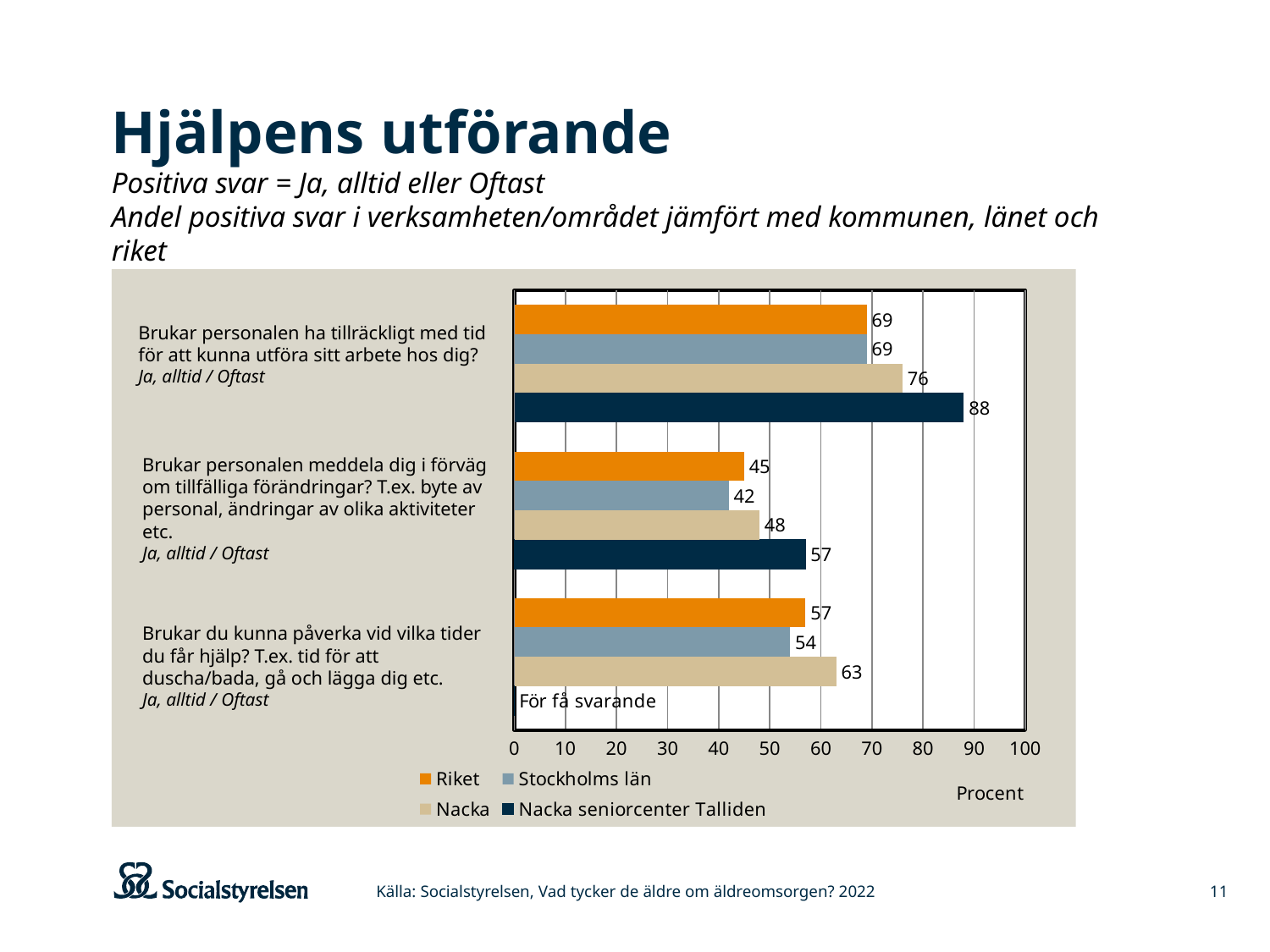
What value is shown for Nacka seniorcenter Talliden on the question about whether staff usually have enough time to do their work ("Brukar personalen ha tillräckligt med tid...")? 88 Which series has the lowest value on the question about staff informing in advance about temporary changes ("Brukar personalen meddela dig i förväg...")? Stockholms län What is the label of the x axis? Procent What value is shown for Stockholms län on the question about staff informing in advance about temporary changes ("Brukar personalen meddela dig i förväg...")? 42 What text is shown instead of a bar for Nacka seniorcenter Talliden on the question about being able to influence at what times you get help? För få svarande What value is shown for Nacka on the question about being able to influence at what times you get help ("Brukar du kunna påverka vid vilka tider...")? 63 How many series does the legend list? 4 How many question categories are shown on the chart? 3 Which series has the highest value on the question about staff having enough time ("Brukar personalen ha tillräckligt med tid...")? Nacka seniorcenter Talliden What is the difference between Nacka seniorcenter Talliden and Riket on the question about staff having enough time ("Brukar personalen ha tillräckligt med tid...")? 19 What kind of chart is shown on the slide? Bar chart On the question about being able to influence at what times you get help, which is larger: the value for Riket or for Stockholms län? Riket